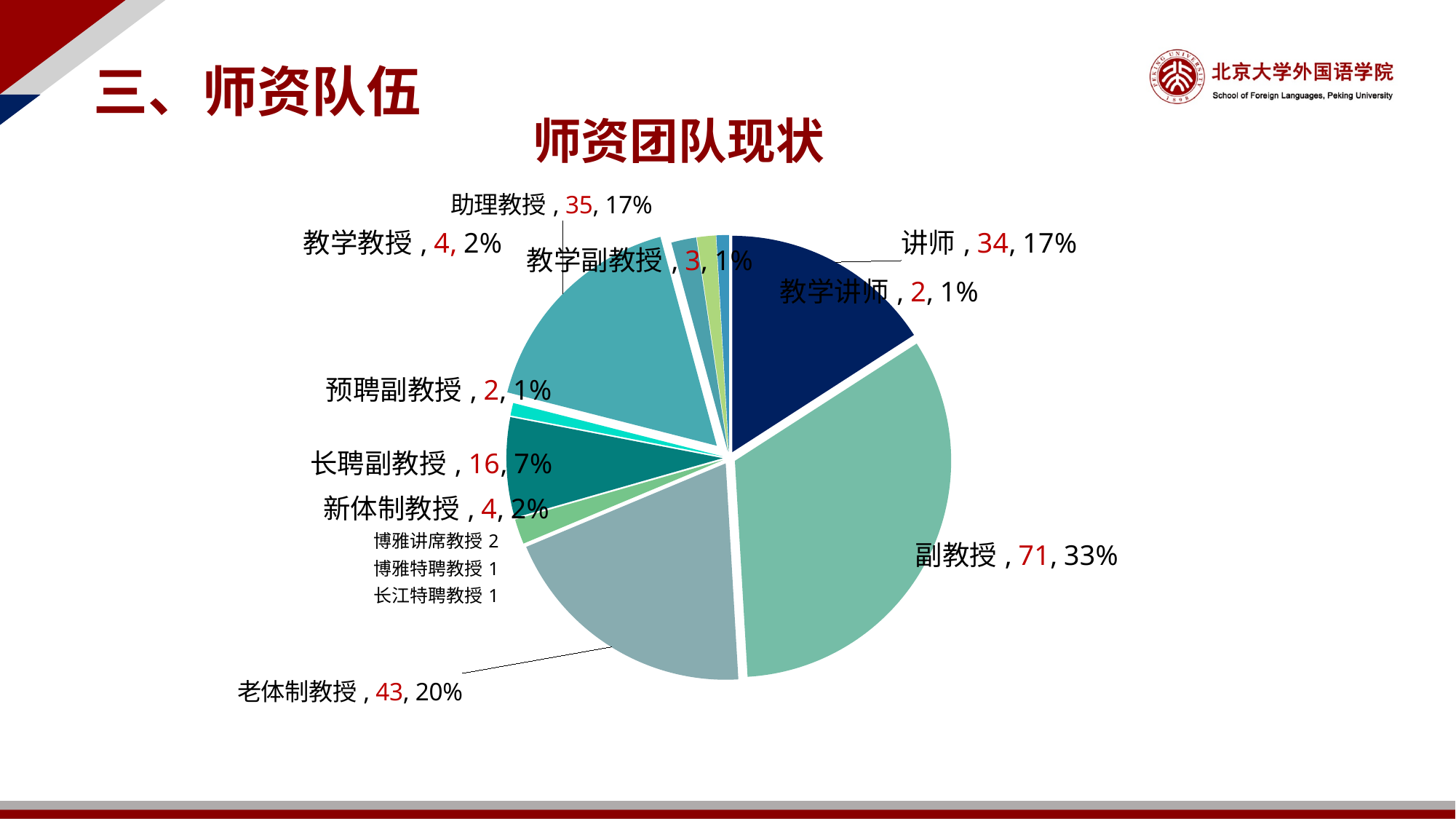
Which is larger, the count for 讲师 or the count for 长聘副教授? 讲师 What share of the pie does 老体制教授 represent? 20% Which category has the largest slice of the pie? 副教授 What percentage share is shown for 长聘副教授? 7% What kind of chart is shown on the slide? pie chart What is the difference between the 副教授 count and the 老体制教授 count? 28 What is the title of the chart? 师资团队现状 How many people are in the 副教授 category? 71 What is the count shown for 教学副教授? 3 How many categories (slices) does the pie chart have? 10 What is the difference between the 助理教授 count and the 讲师 count? 1 How many people are in the 助理教授 category? 35